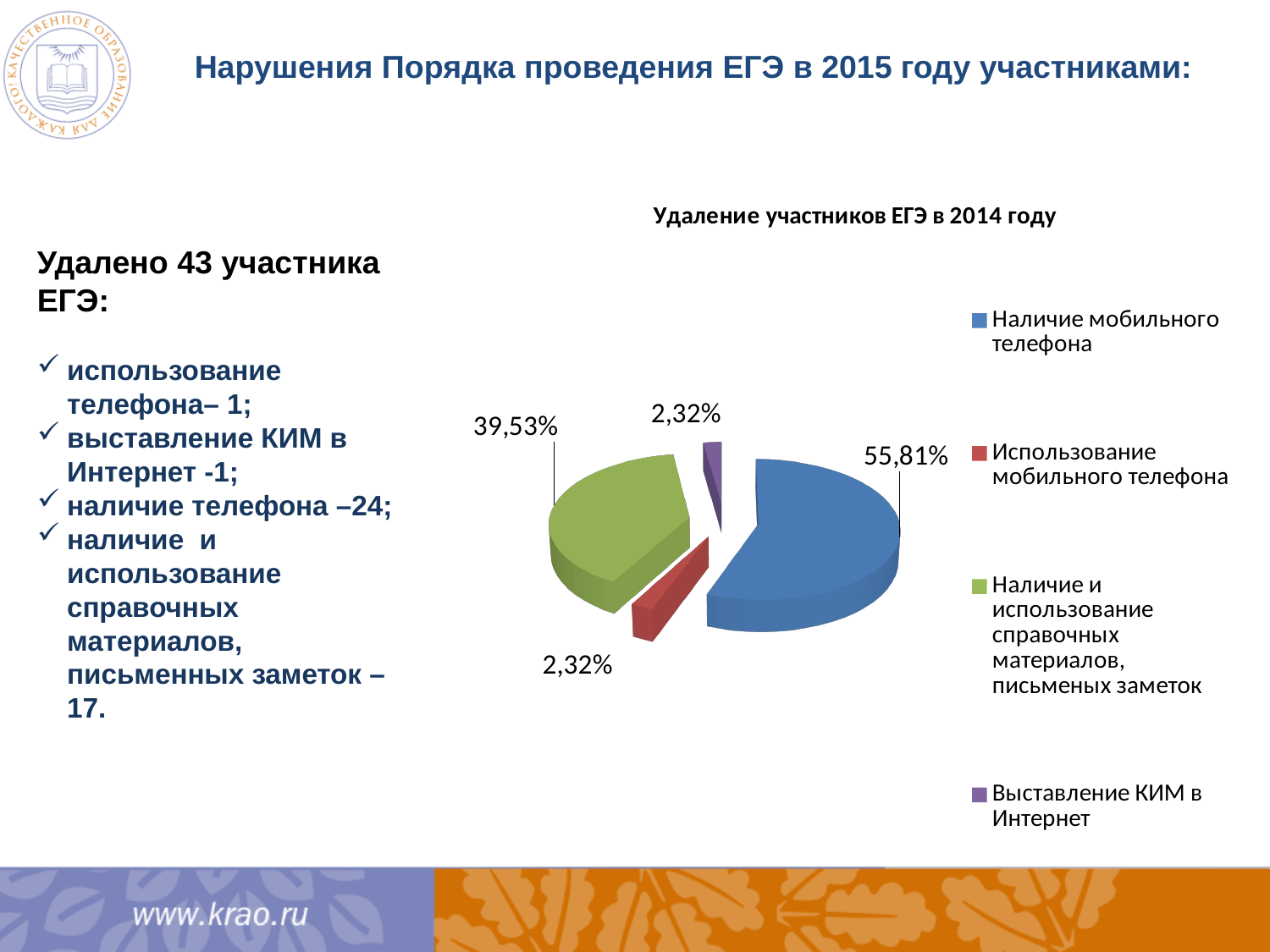
What is the title of the chart? Удаление участников ЕГЭ в 2014 году What colour is the slice for "Наличие и использование справочных материалов, письменых заметок"? Green What is the difference in percentage points between the "Наличие мобильного телефона" slice and the "Наличие и использование справочных материалов, письменых заметок" slice? 16,28 What type of chart is shown on the slide? Pie chart What share of the pie is labelled for "Наличие и использование справочных материалов, письменых заметок"? 39,53% Which category has the largest slice of the pie? Наличие мобильного телефона How many slices does the pie chart have? 4 What share of the pie is labelled for "Использование мобильного телефона"? 2,32% Which is larger: the slice for "Наличие мобильного телефона" or the slice for "Наличие и использование справочных материалов, письменых заметок"? Наличие мобильного телефона How many entries does the chart legend list? 4 What share of the pie is labelled for "Наличие мобильного телефона"? 55,81% What share of the pie is labelled for "Выставление КИМ в Интернет"? 2,32%